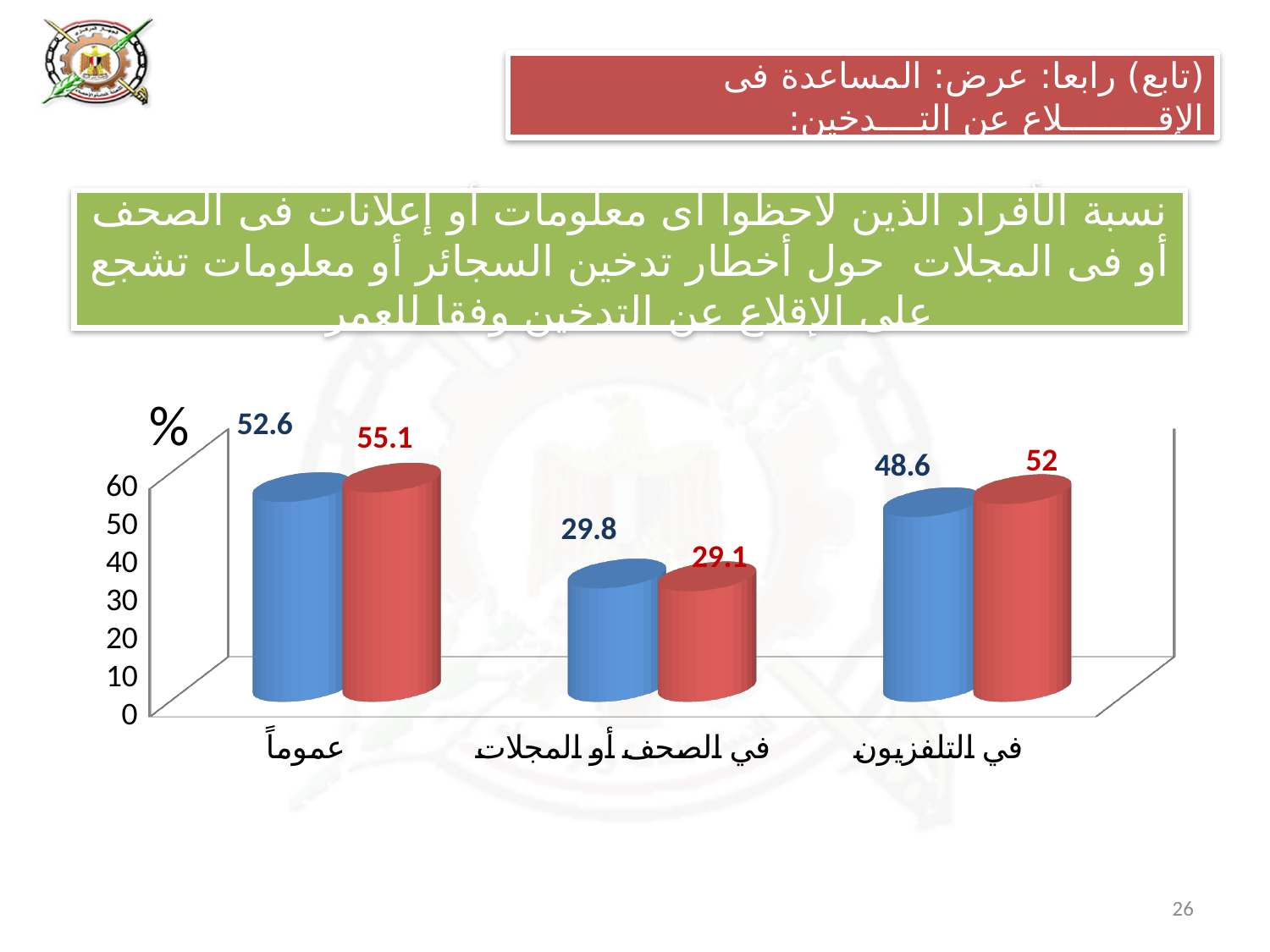
How many categories are shown on the x axis of the chart? 3 What is the value of the blue bar for "في الصحف أو المجلات"? 29.8 What is the value of the red bar for "في التلفزيون"? 52 For "في الصحف أو المجلات", which bar is larger, the blue or the red? blue Which category has the lowest red bar value? في الصحف أو المجلات Is the blue bar value for "في التلفزيون" greater or less than 40? greater What is the difference between the red and blue bars for "في التلفزيون"? 3.4 What is the value of the red bar for the category "عموماً"? 55.1 What is the value of the blue bar for the category "عموماً"? 52.6 What kind of chart is shown on the slide? bar chart What unit symbol is shown at the top of the vertical axis? % Which category has the highest blue bar value? عموماً